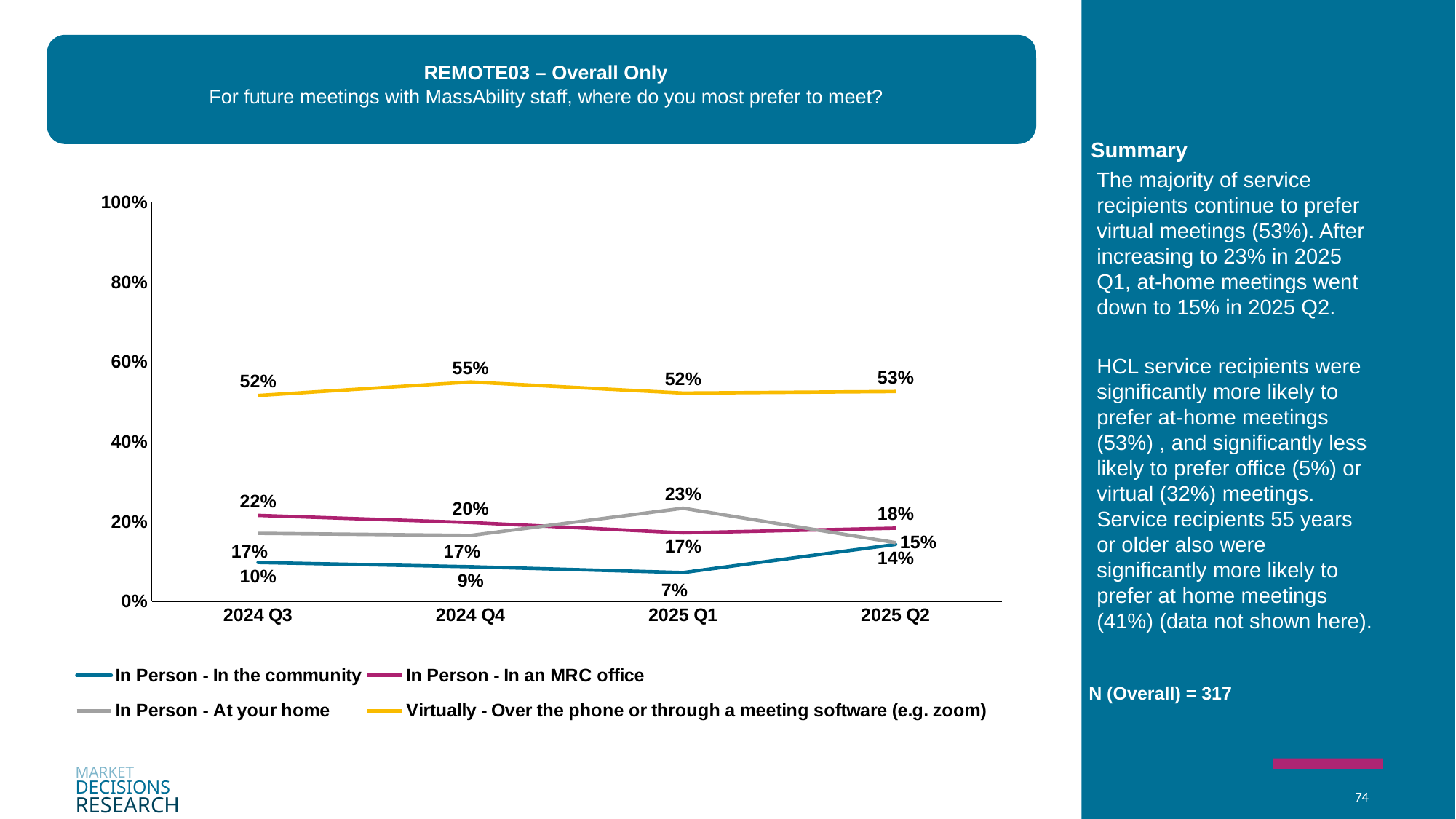
What is the value for 'In Person - In an MRC office' in 2024 Q3? 22% What kind of chart is shown on the slide? Line chart Does the value for 'In Person - In an MRC office' rise or fall from 2024 Q3 to 2025 Q1? Fall How many series does the legend list? 4 How many time periods are shown on the x axis? 4 In which period is the value for 'Virtually - Over the phone or through a meeting software (e.g. zoom)' highest? 2024 Q4 In which period is the value for 'In Person - In the community' lowest? 2025 Q1 What is the value for 'In Person - At your home' in 2025 Q1? 23% In 2025 Q1, which is larger: 'In Person - At your home' or 'In Person - In an MRC office'? In Person - At your home What is the value for 'In Person - In the community' in 2025 Q2? 14% What is the value for 'Virtually - Over the phone or through a meeting software (e.g. zoom)' in 2024 Q4? 55% What is the difference between the 'In Person - At your home' values in 2025 Q1 and 2025 Q2? 8%